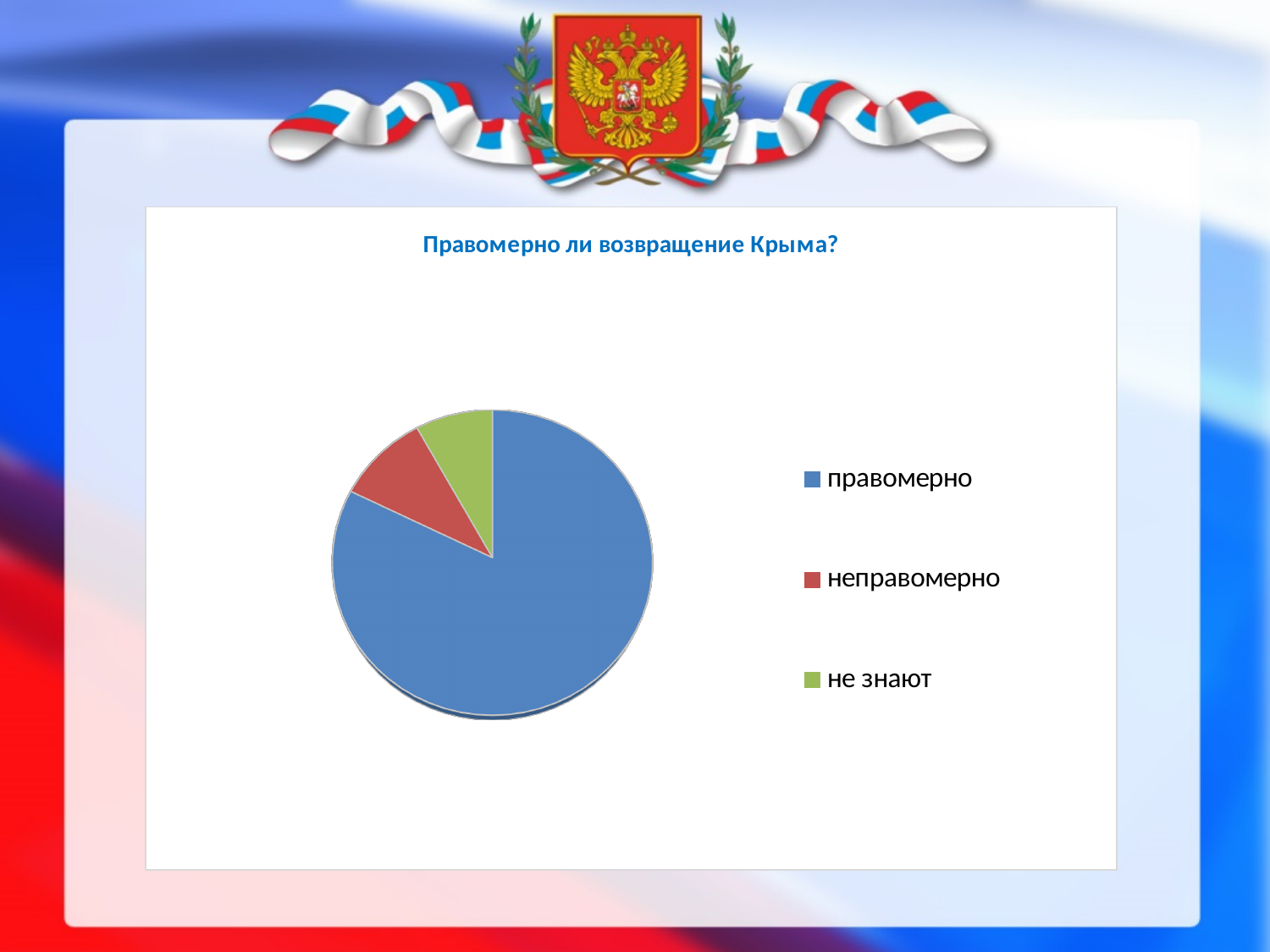
How many categories (slices) does the pie chart have? 3 Which slice is larger: правомерно or неправомерно? правомерно Which slice is larger: правомерно or не знают? правомерно How many entries does the legend list? 3 Which category has the largest slice of the pie? правомерно Which category has the smallest slice of the pie? не знают What is the title of the chart? Правомерно ли возвращение Крыма? Does the slice for правомерно take up more or less than half of the pie? more What colour is the slice for правомерно? blue What kind of chart is shown on the slide? pie chart